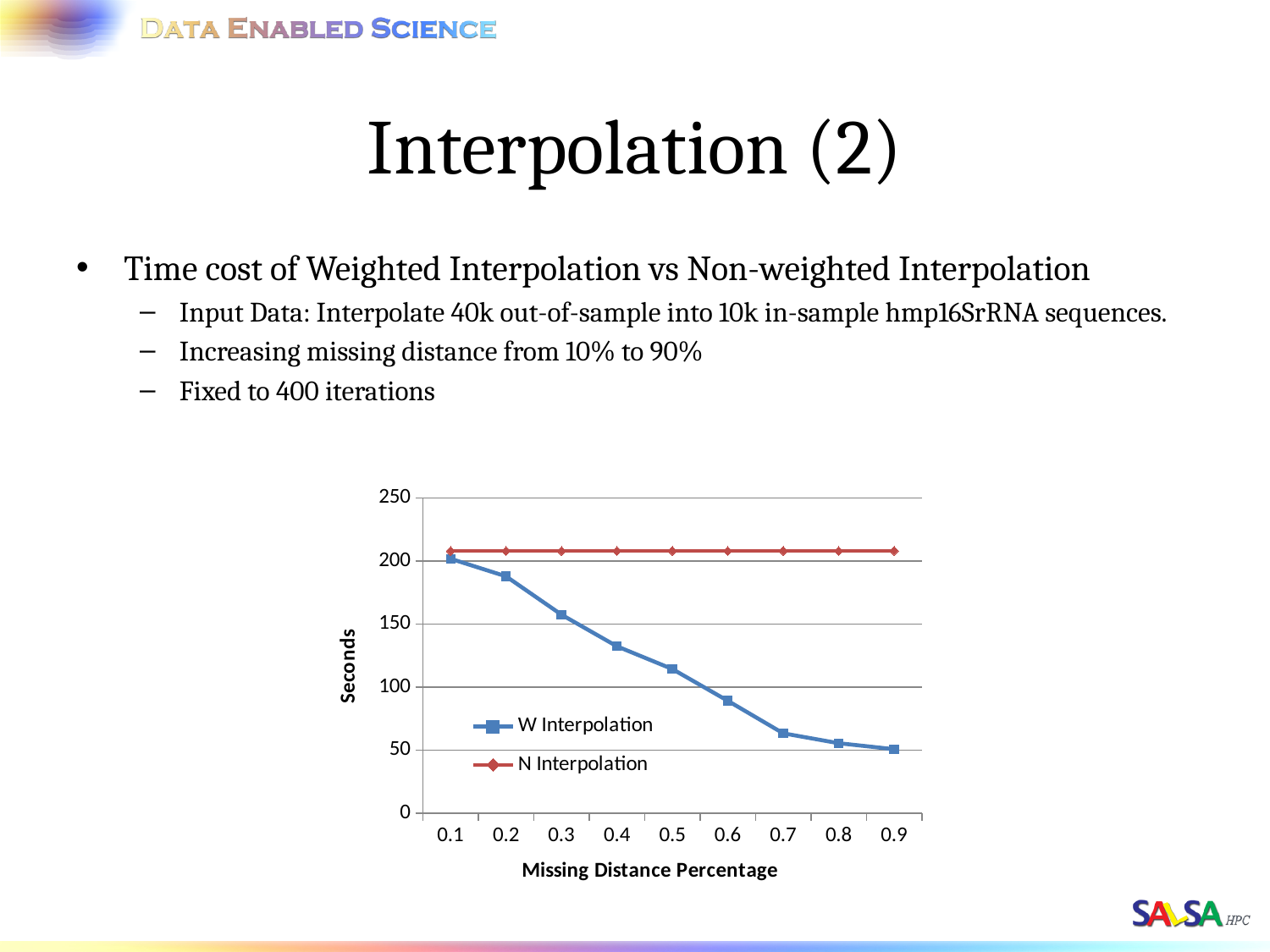
What is the label of the y axis? Seconds Does the W Interpolation series rise or fall as the missing distance percentage increases? fall Is the value for W Interpolation at 0.4 greater or less than 100? greater Is the value for W Interpolation at 0.6 greater or less than 100? less At a missing distance percentage of 0.5, which series has the higher value, W Interpolation or N Interpolation? N Interpolation At which missing distance percentage is the W Interpolation time highest? 0.1 How many series does the chart legend list? 2 Is the value for W Interpolation at 0.2 greater or less than 200? less What is the label of the x axis? Missing Distance Percentage What kind of chart is shown on the slide? line chart How many points are plotted along the x axis for each series? 9